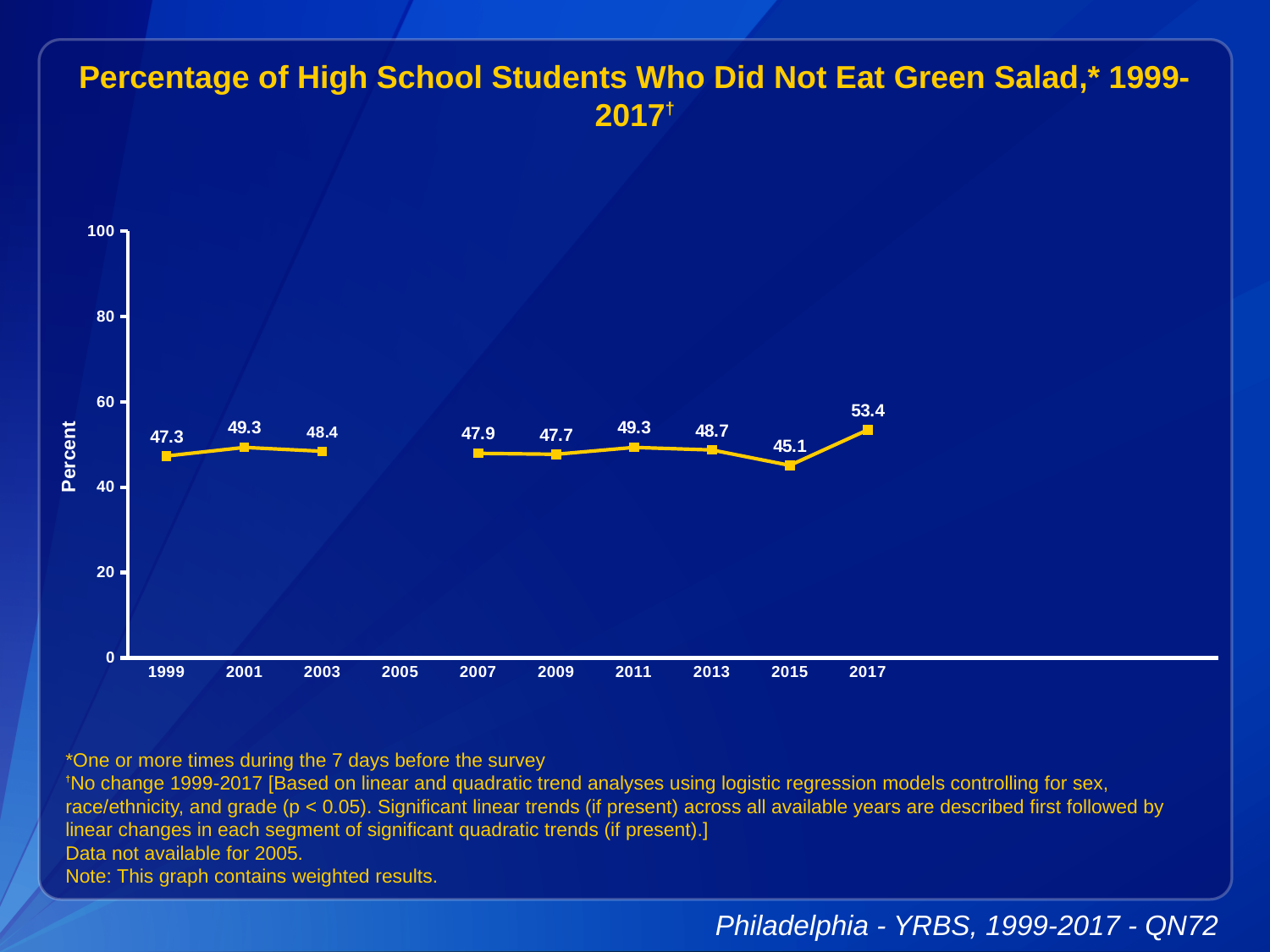
Does the value rise or fall from 2015 to 2017? Rise What is the value for 2015? 45.1 Which year has the lowest value? 2015 Which year has the highest value? 2017 Which is larger, the value for 2001 or the value for 2003? 2001 What is the value for 2017? 53.4 How many data points are plotted on the chart? 9 What is the label on the y axis? Percent What is the value for 1999? 47.3 What is the difference between the values for 2017 and 2015? 8.3 Is the value for 2013 greater or less than 40? greater What kind of chart is shown? Line chart